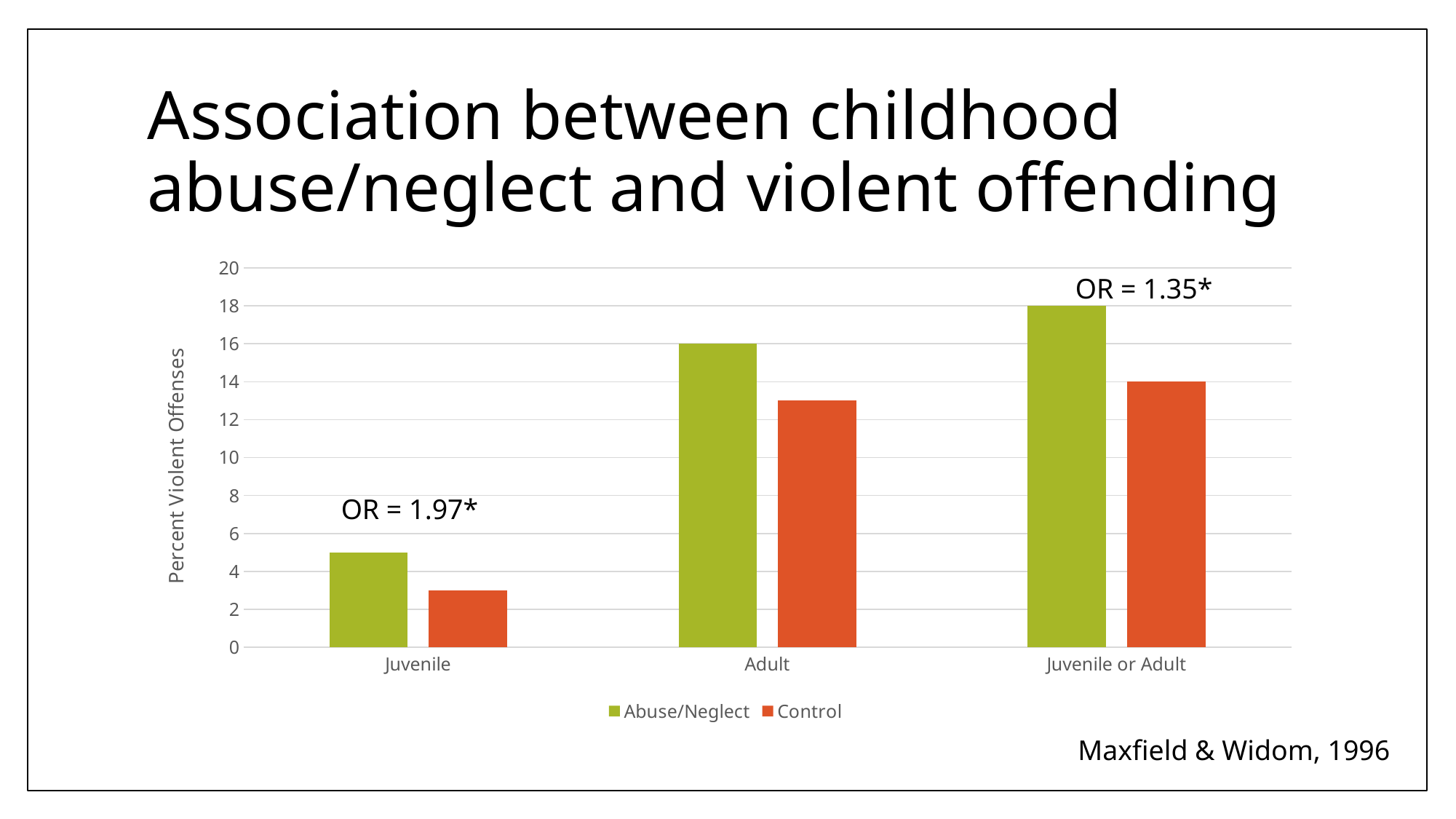
How many categories are shown on the x axis? 3 What kind of chart is shown on the slide? bar chart What odds ratio is annotated above the Juvenile bars? OR = 1.97* What is the difference between the Abuse/Neglect and Control values for the Juvenile or Adult category? 4 What is the Control value for the Juvenile or Adult category? 14 What is the Abuse/Neglect value for the Juvenile or Adult category? 18 How many series does the legend list? 2 Which category has the highest Abuse/Neglect value? Juvenile or Adult What is the Abuse/Neglect value for the Adult category? 16 Is the Control value for the Adult category greater or less than 12? greater Which category has the lowest Control value? Juvenile Is the Abuse/Neglect value for the Juvenile category greater or less than 6? less